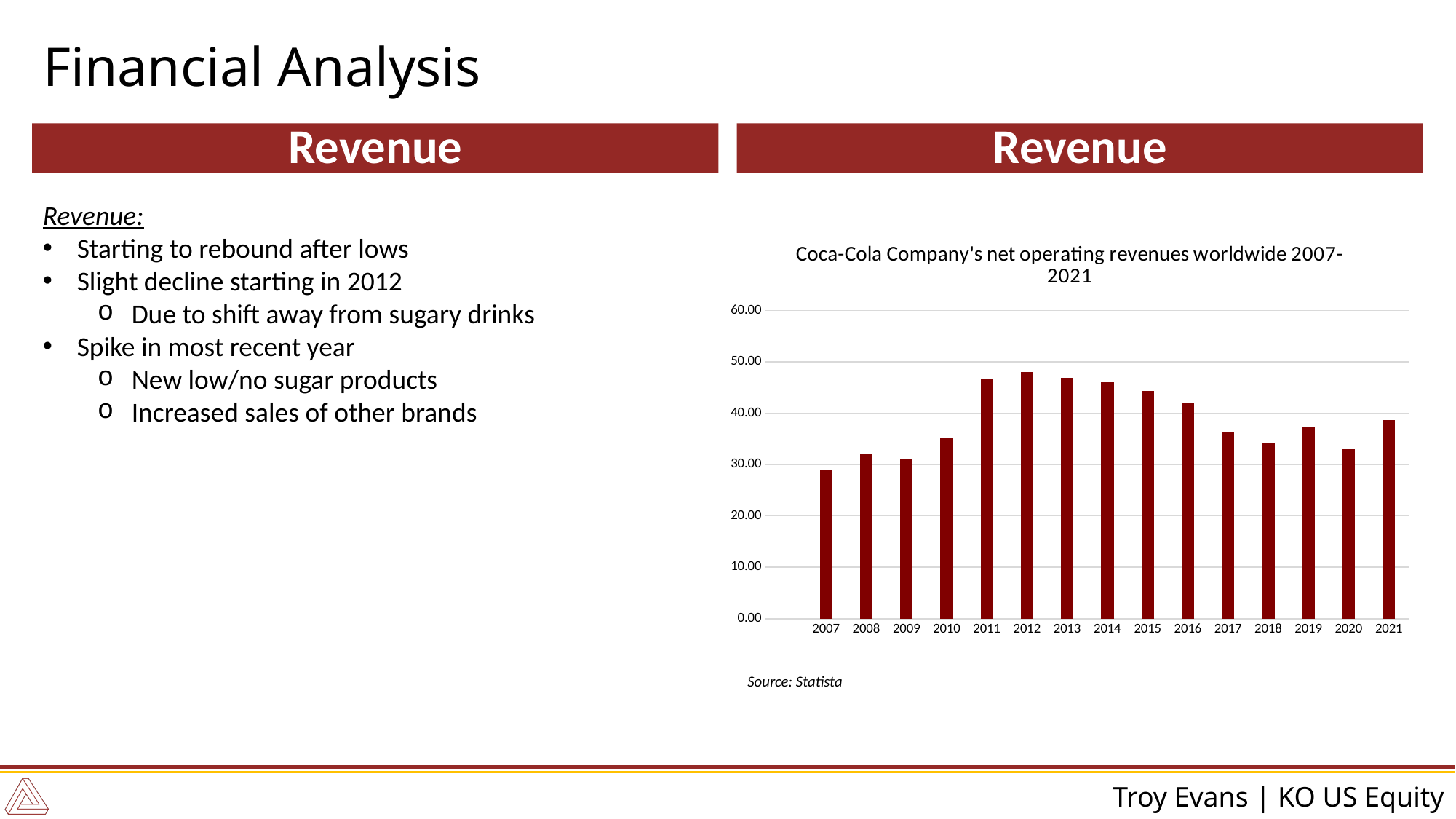
Which year has the lowest net operating revenue in the chart? 2007 Is the value for 2016 greater or less than 40.00? greater Do the values rise or fall from 2012 to 2018? fall Is the value for 2007 greater or less than 30.00? less Is the value for 2012 greater or less than 50.00? less Which year has the highest net operating revenue in the chart? 2012 How many years are plotted on the x axis of the chart? 15 Which year has the larger value, 2011 or 2017? 2011 What is the title of the chart? Coca-Cola Company's net operating revenues worldwide 2007-2021 What kind of chart is shown on the slide? bar chart Which year has the larger value, 2019 or 2020? 2019